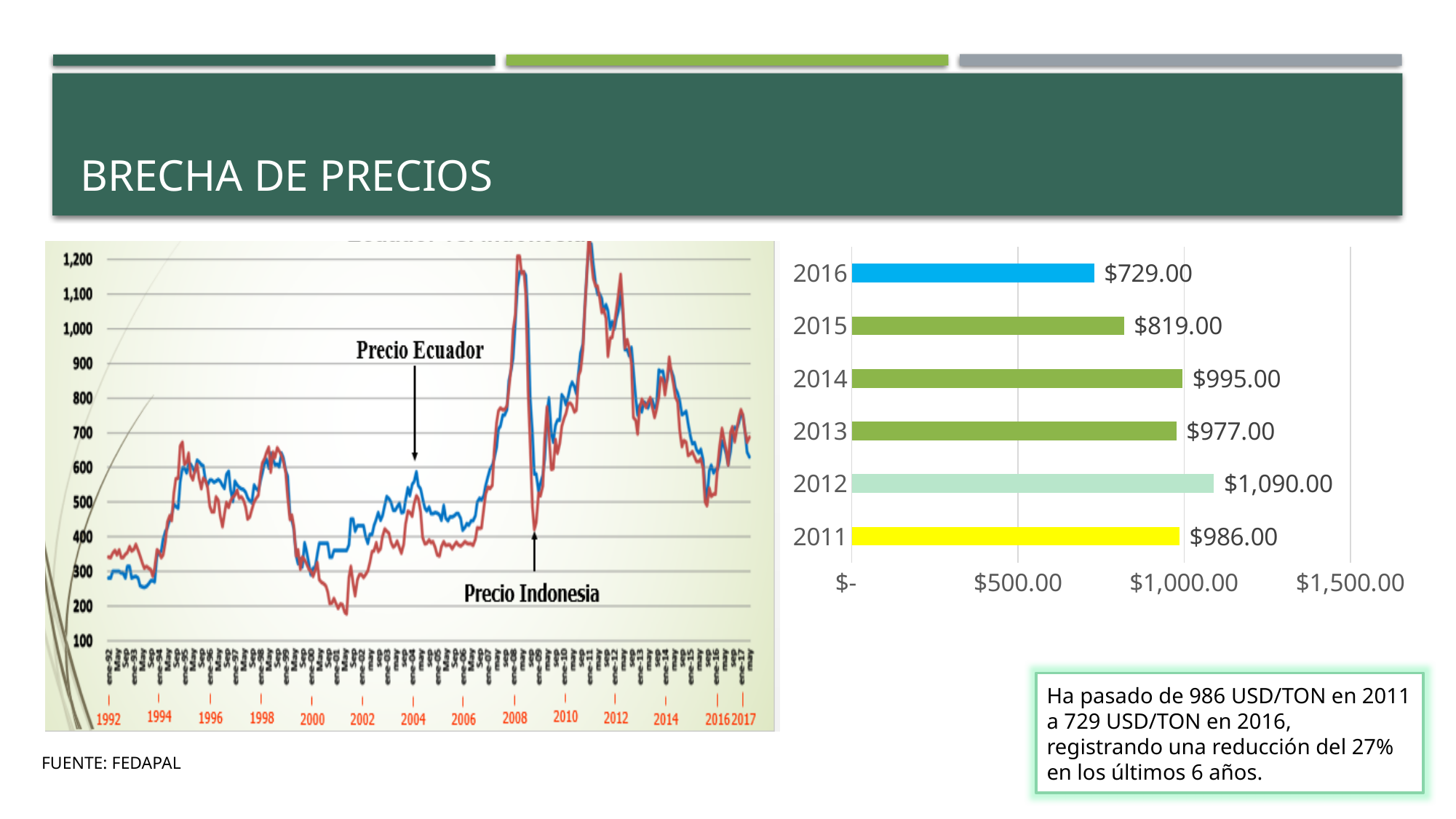
In the bar chart on the right, what is the value for 2016? $729.00 In the bar chart on the right, which year has the highest value? 2012 In the bar chart on the right, what is the value for 2014? $995.00 How many series are plotted in the line chart on the left? 2 In the bar chart on the right, what is the value for 2012? $1,090.00 In the bar chart on the right, which year has the lowest value? 2016 In the bar chart on the right, what is the difference between the values for 2011 and 2016? $257.00 What kind of chart is the chart on the right of the slide? bar chart In the bar chart on the right, is the value for 2015 greater or less than $1,000.00? less In the bar chart on the right, which is larger, the value for 2013 or the value for 2015? 2013 How many years are shown in the bar chart on the right? 6 What kind of chart is the chart on the left of the slide? line chart